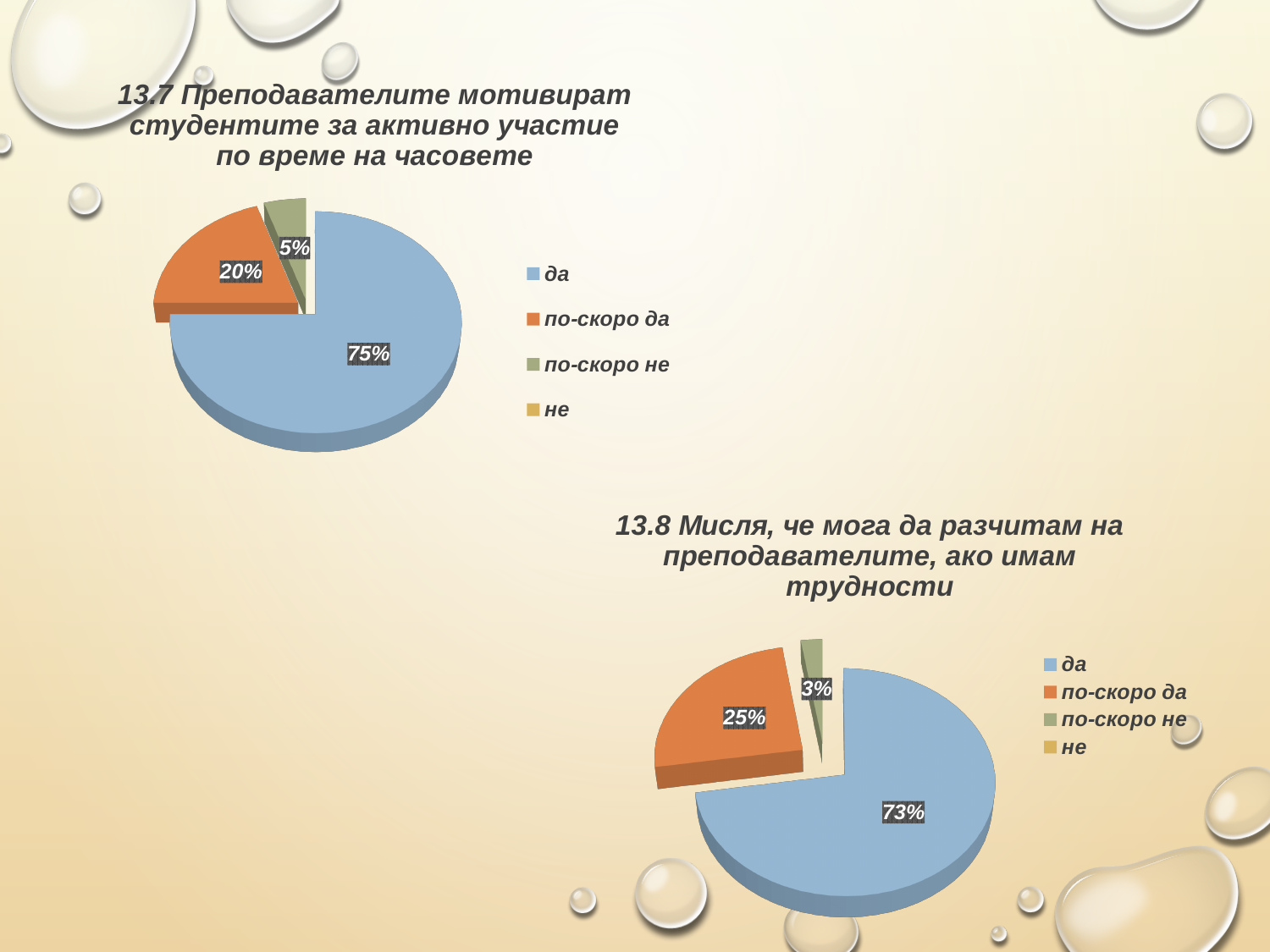
How many entries does the legend of the chart titled "13.7 Преподавателите мотивират студентите за активно участие по време на часовете" list? 4 In the chart titled "13.8 Мисля, че мога да разчитам на преподавателите, ако имам трудности", which labelled slice is the smallest? по-скоро не Which is larger: the "по-скоро да" slice in the chart titled "13.7 Преподавателите мотивират студентите за активно участие по време на часовете" or the "по-скоро да" slice in the chart titled "13.8 Мисля, че мога да разчитам на преподавателите, ако имам трудности"? 13.8 (25%) In the chart titled "13.7 Преподавателите мотивират студентите за активно участие по време на часовете", what percentage is shown for "по-скоро не"? 5% In the chart titled "13.7 Преподавателите мотивират студентите за активно участие по време на часовете", what percentage is shown for "по-скоро да"? 20% In the chart titled "13.7 Преподавателите мотивират студентите за активно участие по време на часовете", what percentage is shown for "да"? 75% In the chart titled "13.8 Мисля, че мога да разчитам на преподавателите, ако имам трудности", what percentage is shown for "по-скоро да"? 25% In the chart titled "13.7 Преподавателите мотивират студентите за активно участие по време на часовете", what is the difference between the "да" and "по-скоро да" slices? 55% In the chart titled "13.8 Мисля, че мога да разчитам на преподавателите, ако имам трудности", what percentage is shown for "по-скоро не"? 3% In the chart titled "13.7 Преподавателите мотивират студентите за активно участие по време на часовете", which category has the largest slice? да What type of chart is used for "13.8 Мисля, че мога да разчитам на преподавателите, ако имам трудности"? Pie chart In the chart titled "13.8 Мисля, че мога да разчитам на преподавателите, ако имам трудности", what percentage is shown for "да"? 73%